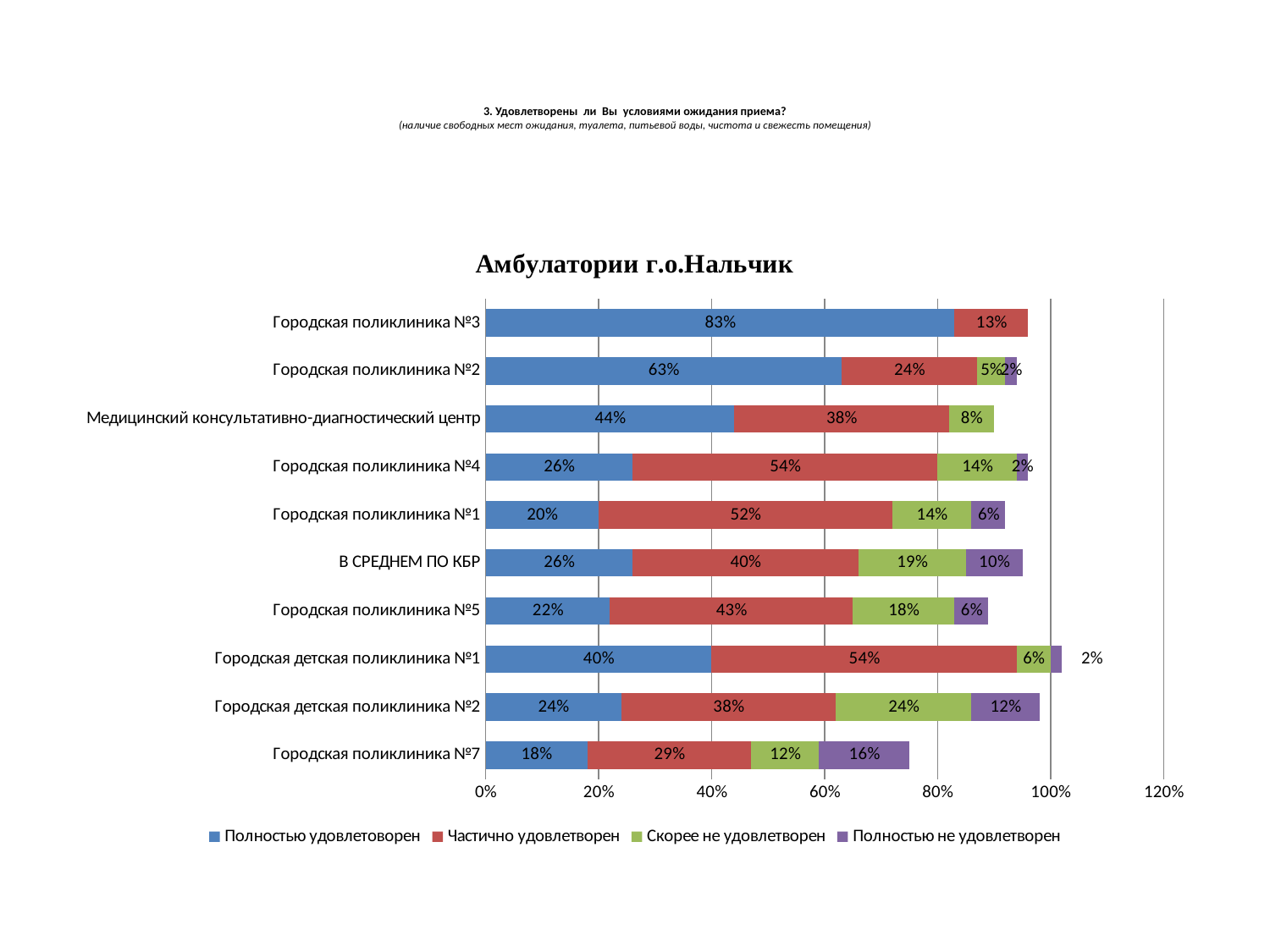
What is the total of the stacked bar for Городская поликлиника №7? 75% How many series does the legend list? 4 What is the value of Полностью не удовлетворен for Городская поликлиника №7? 16% What is the title of the chart? Амбулатории г.о.Нальчик What is the value of Частично удовлетворен for Городская поликлиника №4? 54% How many categories are shown on the chart? 10 What kind of chart is shown on the slide? Stacked bar chart Which category has the highest value for Полностью удовлетоворен? Городская поликлиника №3 Which has a larger Скорее не удовлетворен value: Городская детская поликлиника №2 or Городская поликлиника №5? Городская детская поликлиника №2 Which category has the lowest value for Полностью удовлетоворен? Городская поликлиника №7 What is the difference between the Полностью удовлетоворен values for Городская поликлиника №2 and Медицинский консультативно-диагностический центр? 19% What percentage of respondents at Городская поликлиника №3 were fully satisfied (Полностью удовлетоворен)? 83%